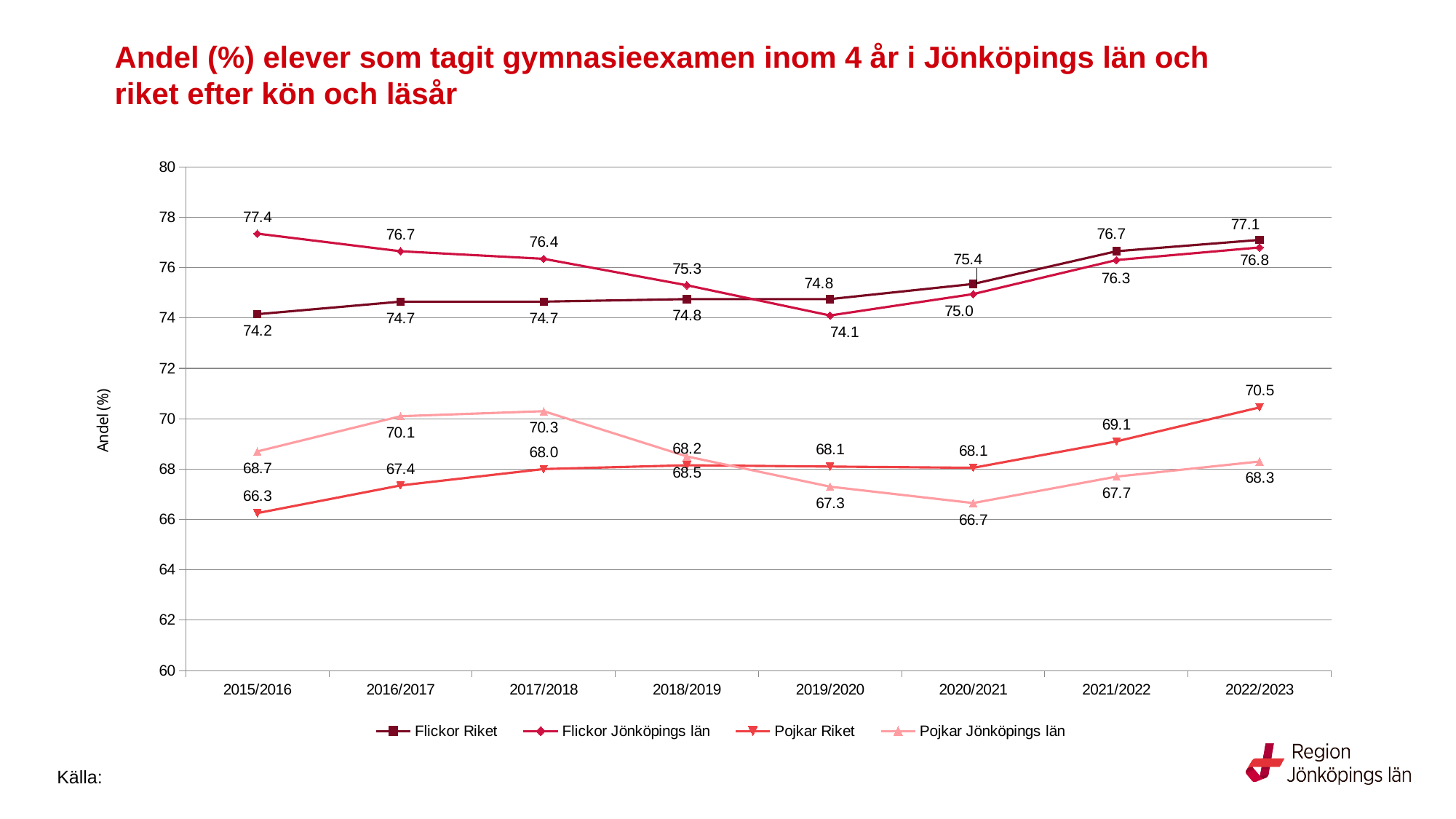
How many series does the legend list? 4 In which school year is the value for Flickor Jönköpings län highest? 2015/2016 What is the value for Flickor Jönköpings län in 2015/2016? 77.4 What is the title of the y axis? Andel (%) Does the value for Pojkar Riket generally rise or fall from 2015/2016 to 2022/2023? Rise What is the value for Pojkar Riket in 2022/2023? 70.5 In 2019/2020, which is larger: Flickor Riket or Flickor Jönköpings län? Flickor Riket What kind of chart is shown on the slide? Line chart By how much did the value for Flickor Riket increase from 2015/2016 to 2022/2023? 2.9 How many school years (läsår) are shown on the x axis? 8 What is the value for Flickor Riket in 2020/2021? 75.4 In which school year is the value for Pojkar Jönköpings län lowest? 2020/2021